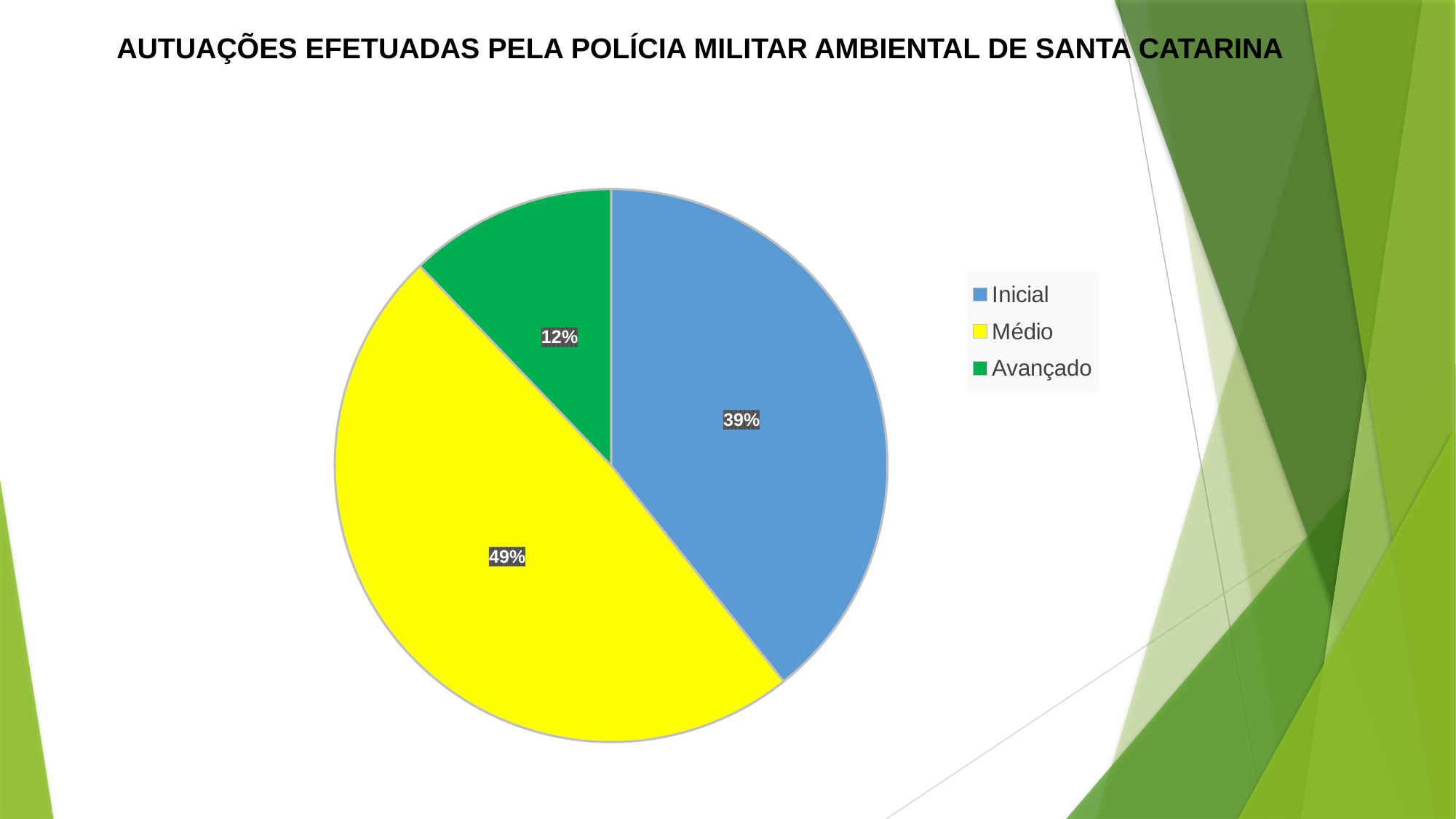
How many categories are shown in the pie chart? 3 What is the difference in percentage points between the Médio and Inicial slices? 10 Which is larger, the Inicial slice or the Avançado slice? Inicial What colour is the Médio slice in the pie chart? Yellow What share of the pie does the Inicial slice represent? 39% Which category has the largest slice of the pie? Médio What share of the pie does the Avançado slice represent? 12% What is the difference in percentage points between the Inicial and Avançado slices? 27 What is the title of the chart? AUTUAÇÕES EFETUADAS PELA POLÍCIA MILITAR AMBIENTAL DE SANTA CATARINA What kind of chart is shown on the slide? Pie chart Which category has the smallest slice of the pie? Avançado What share of the pie does the Médio slice represent? 49%